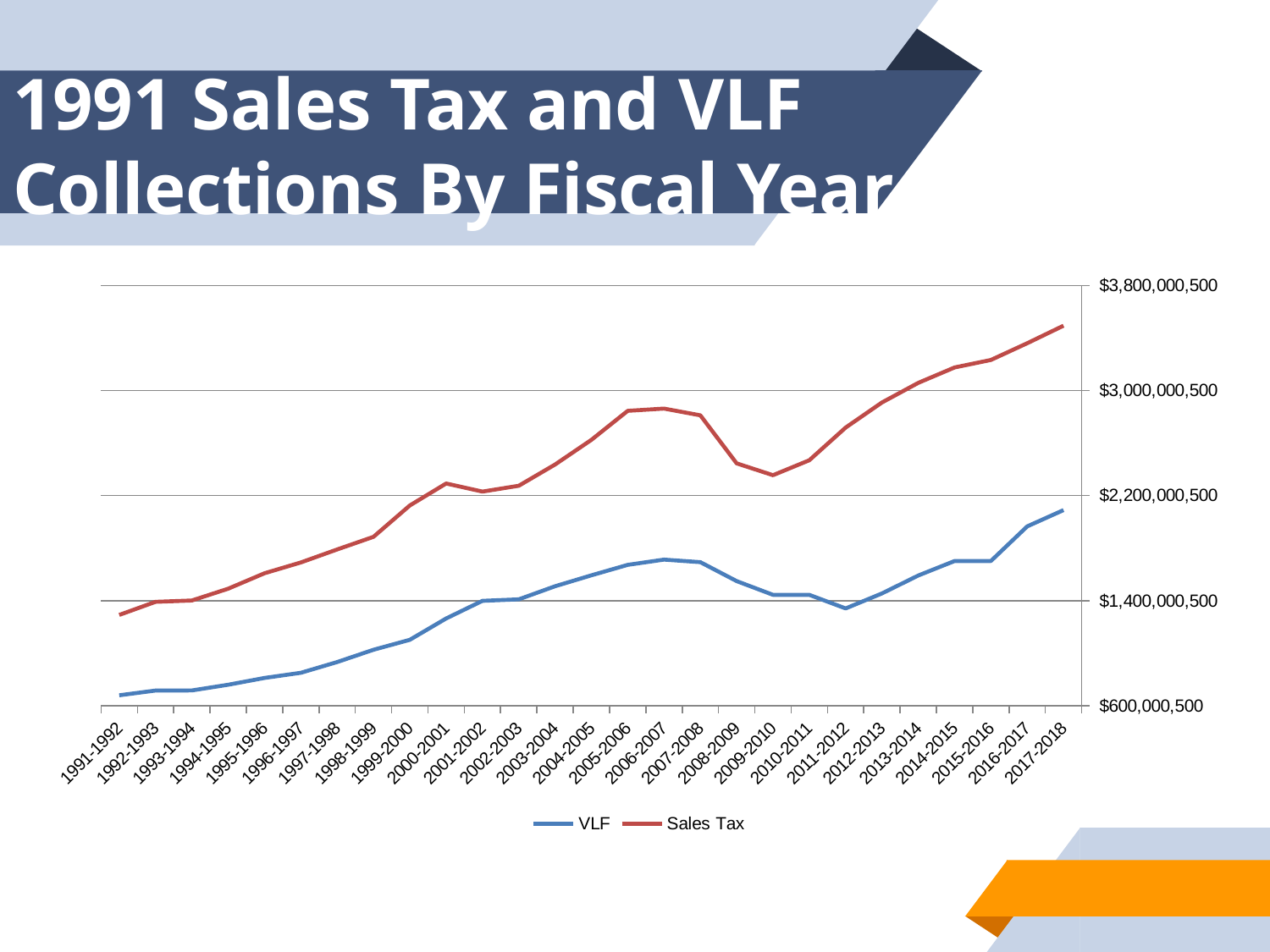
Is the Sales Tax value for 2005-2006 greater or less than $2,200,000,500? greater How many fiscal years are plotted along the x axis? 27 Overall, do the Sales Tax values rise or fall from 1991-1992 to 2017-2018? Rise In which fiscal year is the VLF line at its lowest? 1991-1992 What kind of chart is shown on the slide? Line chart Which series is higher in 2017-2018, VLF or Sales Tax? Sales Tax Which colour is used for the Sales Tax line? Red Is the VLF value for 2017-2018 greater or less than $2,200,000,500? less Is the Sales Tax value for 2017-2018 greater or less than $3,000,000,500? greater In which fiscal year is the Sales Tax line at its highest? 2017-2018 How many series does the legend list? 2